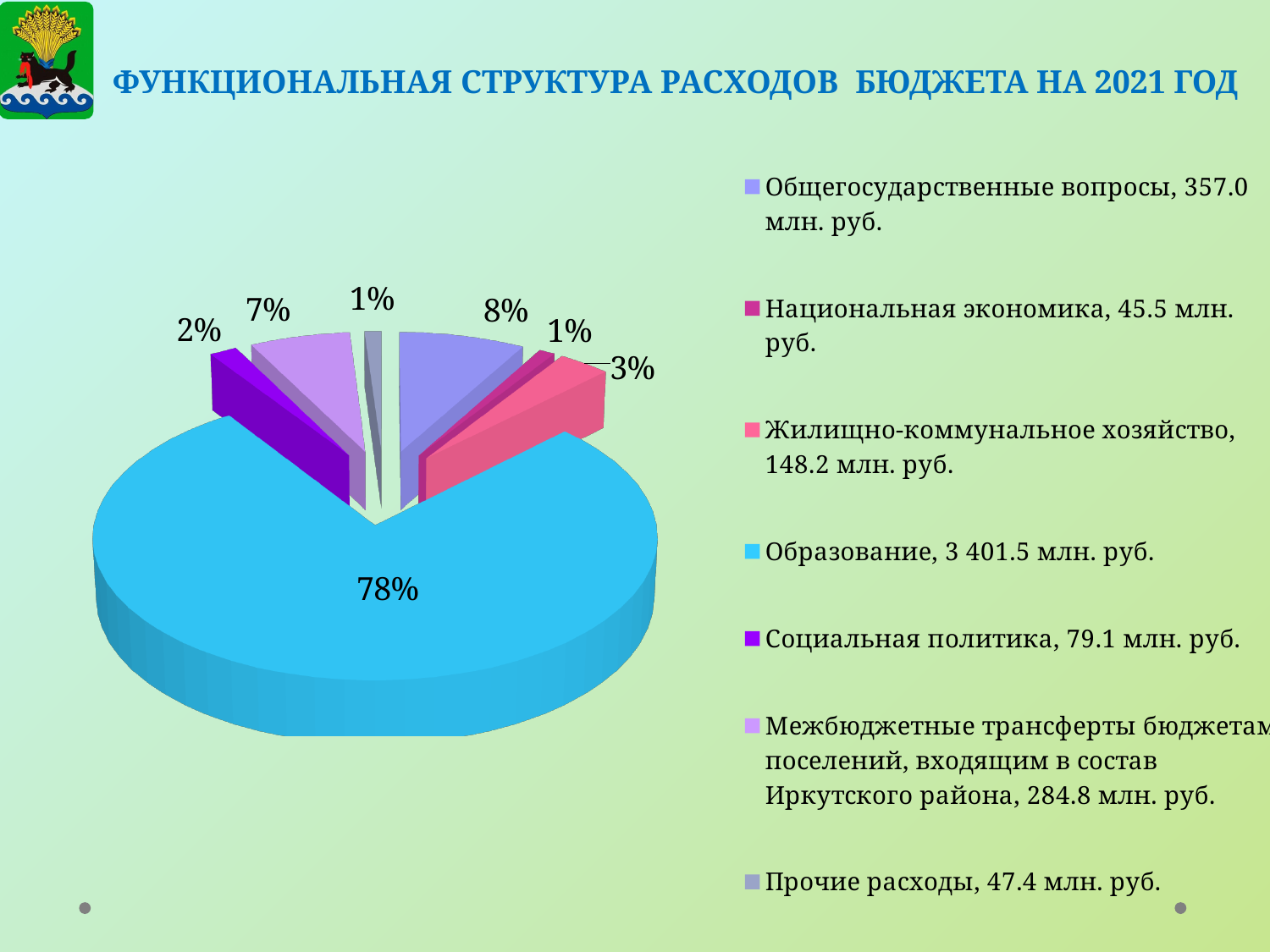
What amount is shown in the legend for Социальная политика? 79.1 млн. руб. How many categories does the pie chart have? 7 What share of the pie does Образование take? 78% What kind of chart is shown on the slide? pie chart What is the difference between the amounts for Общегосударственные вопросы (357.0 млн. руб.) and Межбюджетные трансферты (284.8 млн. руб.)? 72.2 млн. руб. What amount is shown in the legend for Образование? 3 401.5 млн. руб. What share of the pie does Общегосударственные вопросы take? 8% What share of the pie does Межбюджетные трансферты бюджетам поселений take? 7% Which category has the largest share of the pie? Образование Which is larger: the amount for Национальная экономика or for Прочие расходы? Прочие расходы What is the title of the chart slide? ФУНКЦИОНАЛЬНАЯ СТРУКТУРА РАСХОДОВ БЮДЖЕТА НА 2021 ГОД